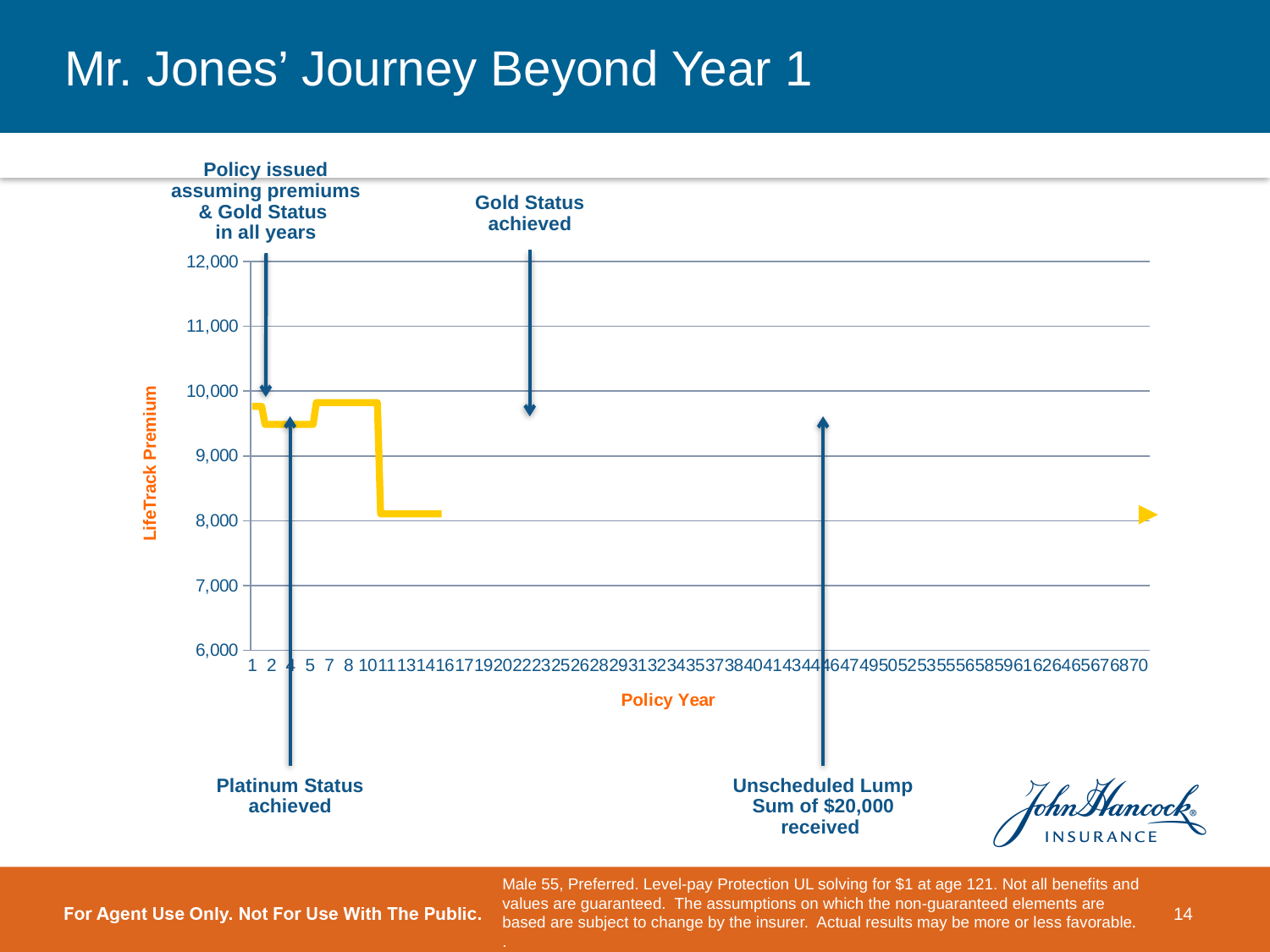
Which has the larger LifeTrack Premium value, policy year 1 or policy year 3? policy year 1 Is the LifeTrack Premium value for policy year 3 greater or less than 9,000? greater What is the title of the vertical axis? LifeTrack Premium Does the LifeTrack Premium line rise or fall between policy year 10 and policy year 14? fall Which has the larger LifeTrack Premium value, policy year 3 or policy year 8? policy year 8 What is the title of the horizontal axis? Policy Year What kind of chart is shown on the slide? line chart Is the LifeTrack Premium value for policy year 8 greater or less than 10,000? less Which has the larger LifeTrack Premium value, policy year 8 or policy year 14? policy year 8 Is the LifeTrack Premium value for policy year 14 greater or less than 9,000? less